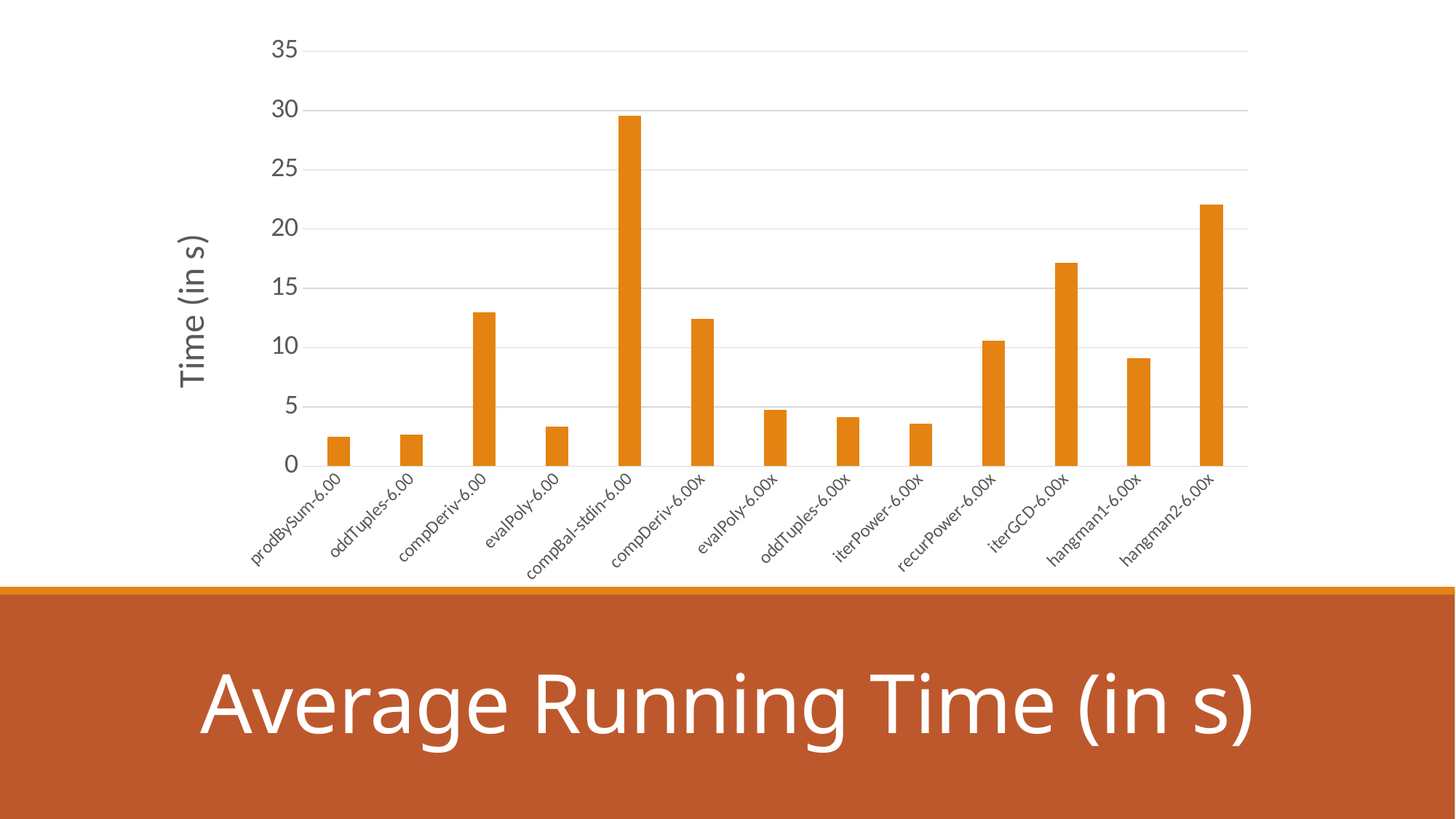
Is the value for iterGCD-6.00x greater or less than 15? greater Is the value for evalPoly-6.00 greater or less than 5? less Is the value for compBal-stdin-6.00 greater or less than 25? greater How many categories (bars) are plotted in the chart? 13 Which has a larger value, hangman1-6.00x or hangman2-6.00x? hangman2-6.00x What kind of chart is shown on the slide? bar chart Which has a larger value, hangman2-6.00x or iterGCD-6.00x? hangman2-6.00x Which category has the highest average running time? compBal-stdin-6.00 What is the label on the vertical axis of the chart? Time (in s)